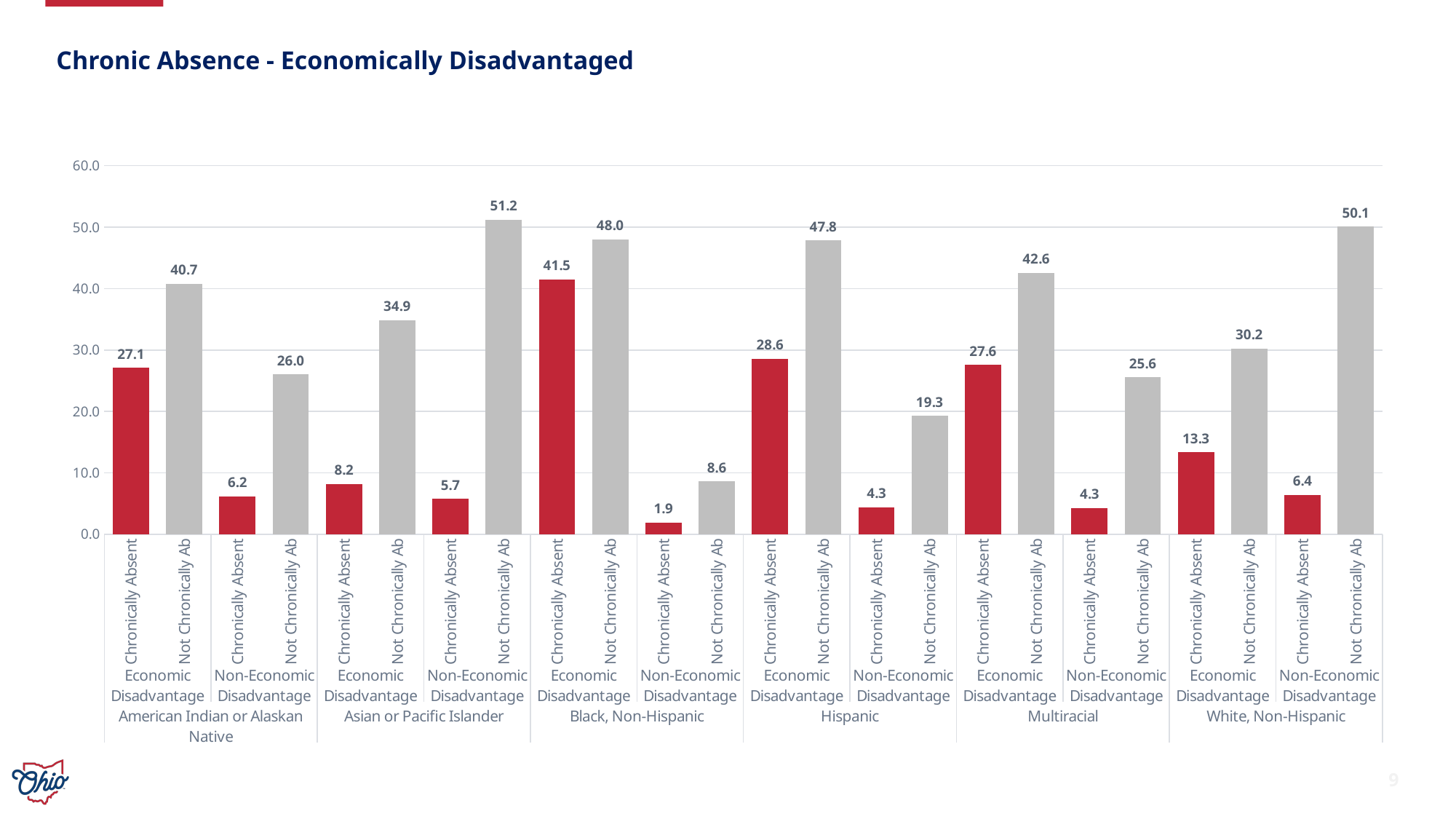
What is the title of the chart? Chronic Absence - Economically Disadvantaged What is the difference between the Chronically Absent values for Economic Disadvantage and Non-Economic Disadvantage in the American Indian or Alaskan Native group? 20.9 Which bar has the lowest value on the chart? Chronically Absent, Non-Economic Disadvantage, Black, Non-Hispanic (1.9) What type of chart is shown on the slide? Bar chart Which bar has the highest value on the chart? Not Chronically Absent, Non-Economic Disadvantage, Asian or Pacific Islander (51.2) How many bars are plotted on the chart in total? 24 What is the value for Chronically Absent students with Economic Disadvantage in the Black, Non-Hispanic group? 41.5 What is the value for Chronically Absent students with Non-Economic Disadvantage in the Asian or Pacific Islander group? 5.7 Which is larger: the Chronically Absent value for Economic Disadvantage in the Multiracial group or in the White, Non-Hispanic group? Multiracial (27.6) How many racial/ethnic groups are shown on the x axis? 6 What is the value for Chronically Absent students with Economic Disadvantage in the Hispanic group? 28.6 What is the value for Not Chronically Absent students with Non-Economic Disadvantage in the White, Non-Hispanic group? 50.1